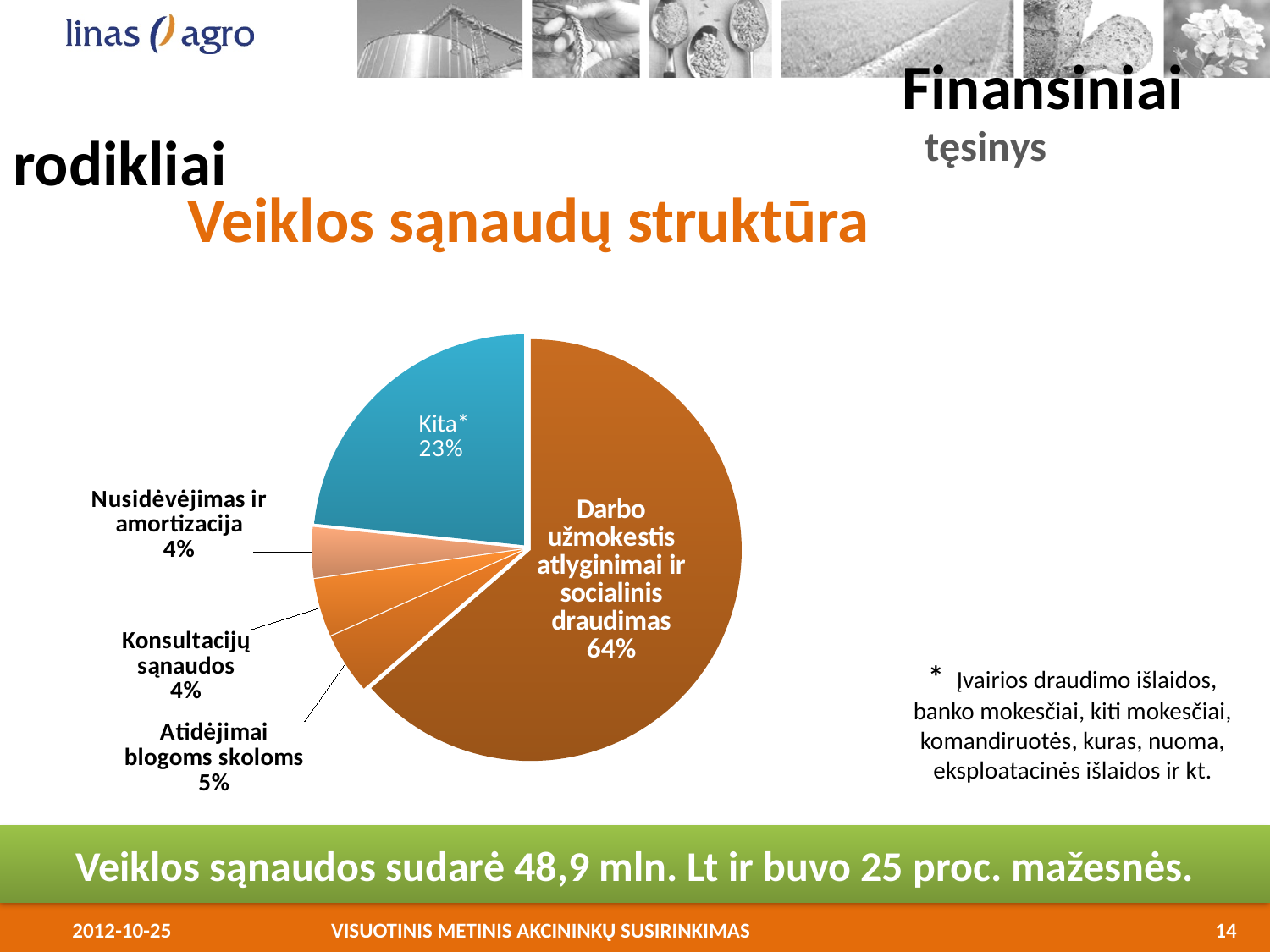
What is the difference in percentage points between 'Darbo užmokestis atlyginimai ir socialinis draudimas' and 'Kita*'? 41 percentage points Which is larger, the slice for 'Kita*' or the slice for 'Atidėjimai blogoms skoloms'? Kita* What is the difference in percentage points between 'Atidėjimai blogoms skoloms' and 'Konsultacijų sąnaudos'? 1 percentage point What is the value shown for 'Nusidėvėjimas ir amortizacija'? 4% Which category has the largest slice of the pie? Darbo užmokestis atlyginimai ir socialinis draudimas What kind of chart is shown on the slide? Pie chart What is the value shown for 'Atidėjimai blogoms skoloms'? 5% What share of the pie is 'Darbo užmokestis atlyginimai ir socialinis draudimas'? 64% What is the title of the chart? Veiklos sąnaudų struktūra What share of the pie is 'Kita*'? 23% How many slices does the pie chart have? 5 What is the value shown for 'Konsultacijų sąnaudos'? 4%